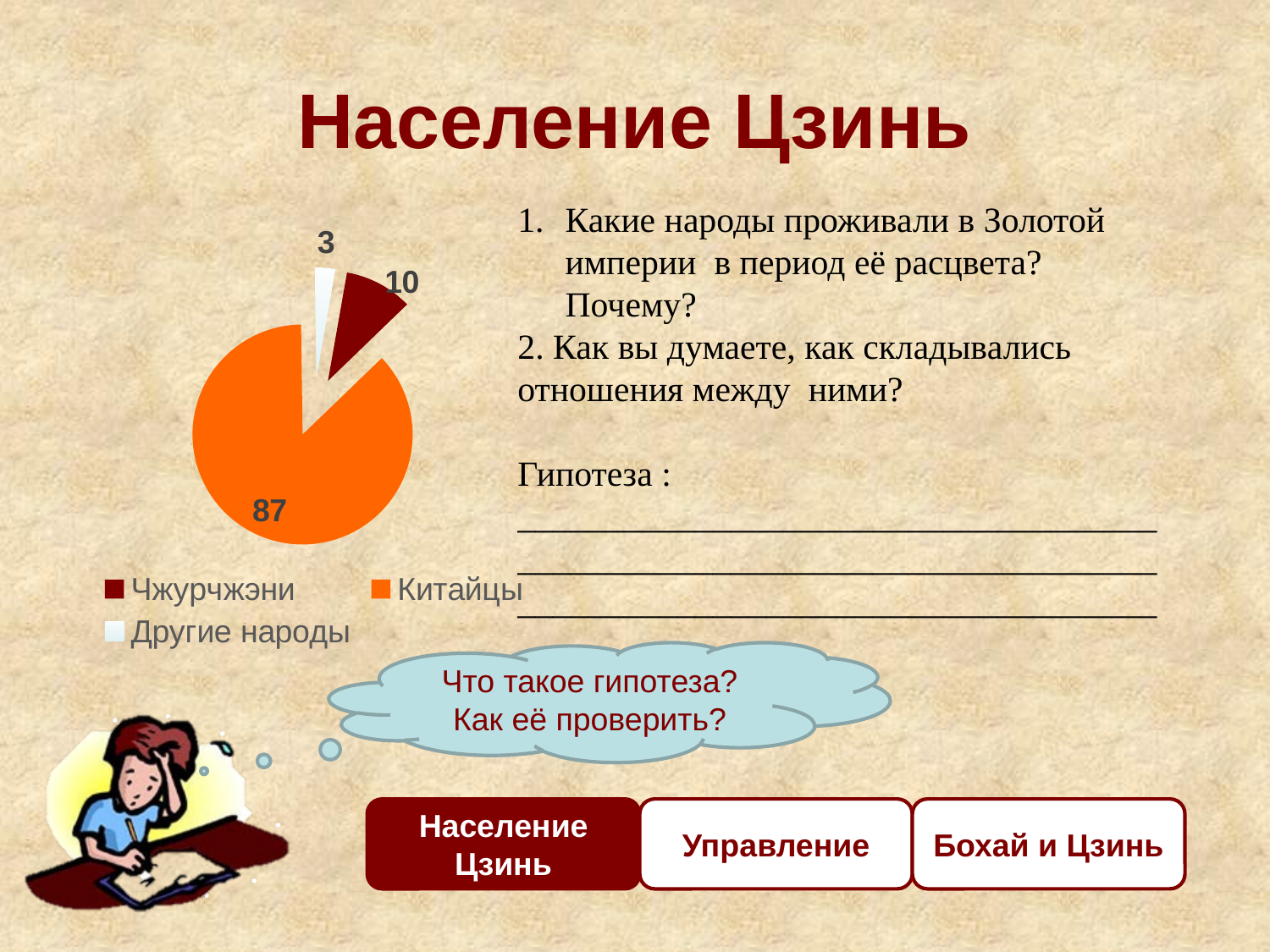
What is the difference between the values for Китайцы and Чжурчжэни? 77 Which category has the smallest slice in the pie chart? Другие народы What is the value for Другие народы in the pie chart? 3 What is the difference between the values for Чжурчжэни and Другие народы? 7 How many slices does the pie chart have? 3 Which is larger, the value for Чжурчжэни or the value for Другие народы? Чжурчжэни Which category has the largest slice in the pie chart? Китайцы How many entries does the legend list? 3 What is the value for Чжурчжэни in the pie chart? 10 What is the value for Китайцы in the pie chart? 87 What colour is the slice for Китайцы? orange What kind of chart is shown on the slide? pie chart